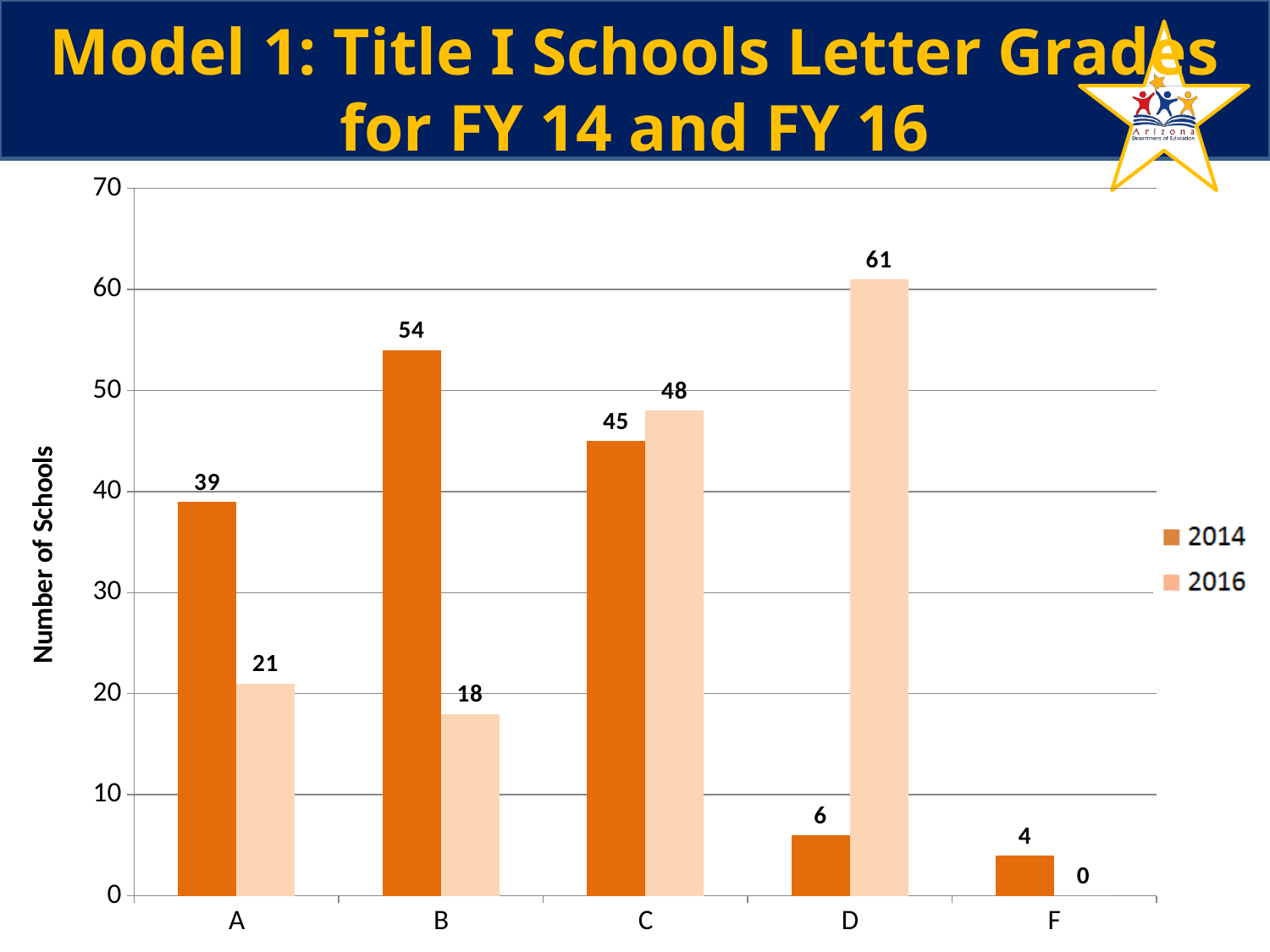
What is the difference between the 2014 and 2016 values for grade B? 36 Which letter grade has the highest number of schools in the 2014 series? B What is the difference between the 2016 value for grade D and the 2014 value for grade D? 55 How many series does the legend list? 2 How many Title I schools received a letter grade of D in 2016? 61 Which letter grade has the lowest number of schools in the 2016 series? F How many Title I schools received a letter grade of A in 2014? 39 What kind of chart is shown on the slide? Bar chart What is the label of the vertical axis? Number of Schools What is the value for grade F in the 2016 series? 0 Which is larger for grade C: the 2014 value or the 2016 value? 2016 How many letter grade categories are shown on the x axis? 5